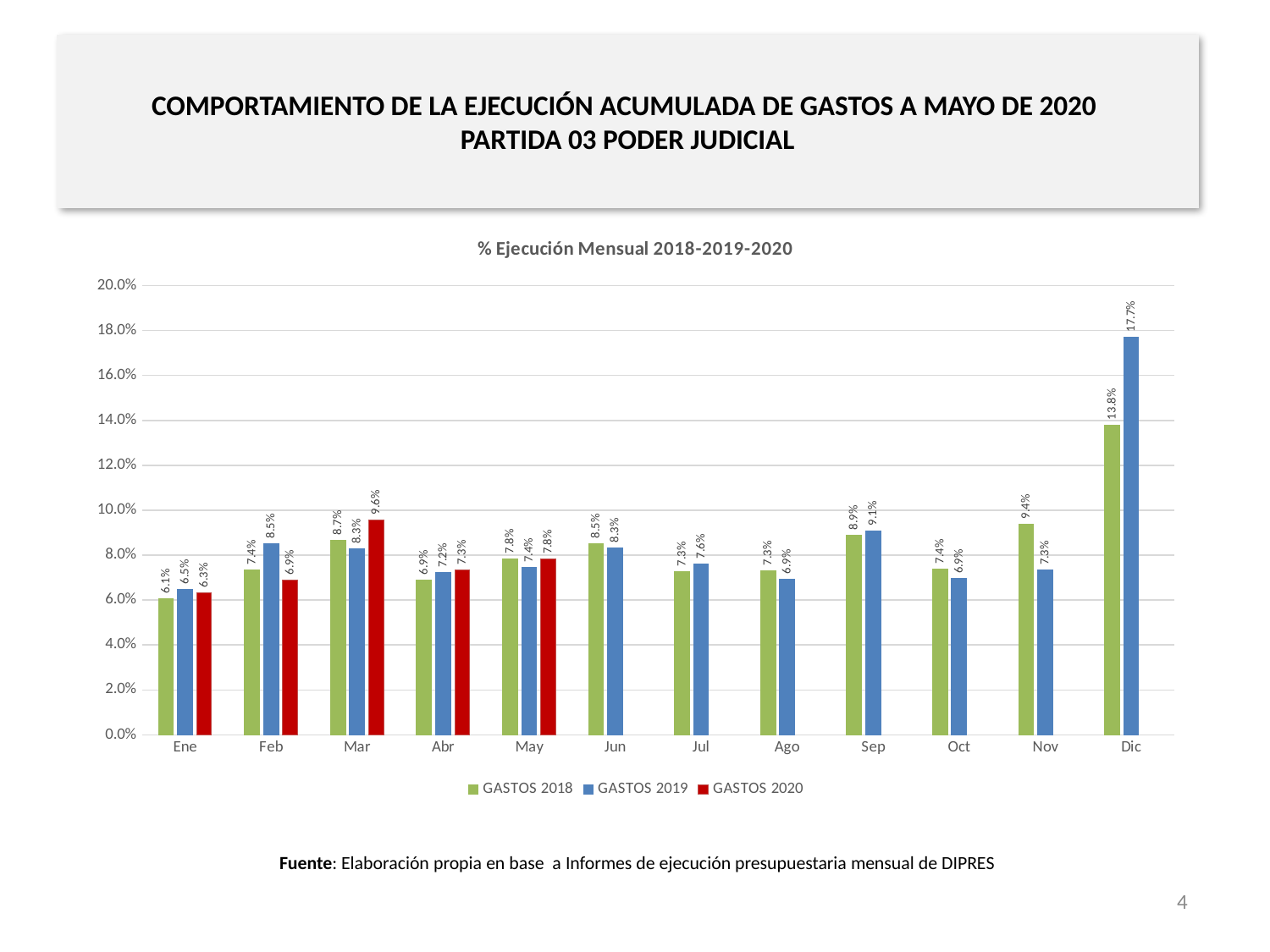
What is the value for GASTOS 2020 in Mar? 9.6% What is the title of the chart? % Ejecución Mensual 2018-2019-2020 Is the value for GASTOS 2019 in Dic greater or less than 16.0%? greater How many months are shown on the x axis? 12 What is the value for GASTOS 2019 in Dic? 17.7% What is the value for GASTOS 2018 in Nov? 9.4% Which month has the highest value for GASTOS 2018? Dic What kind of chart is shown? bar chart What is the difference between GASTOS 2019 and GASTOS 2018 in Dic? 3.9% Which month has the lowest value for GASTOS 2019? Ene How many series does the legend list? 3 Which is larger in Feb: GASTOS 2019 or GASTOS 2020? GASTOS 2019